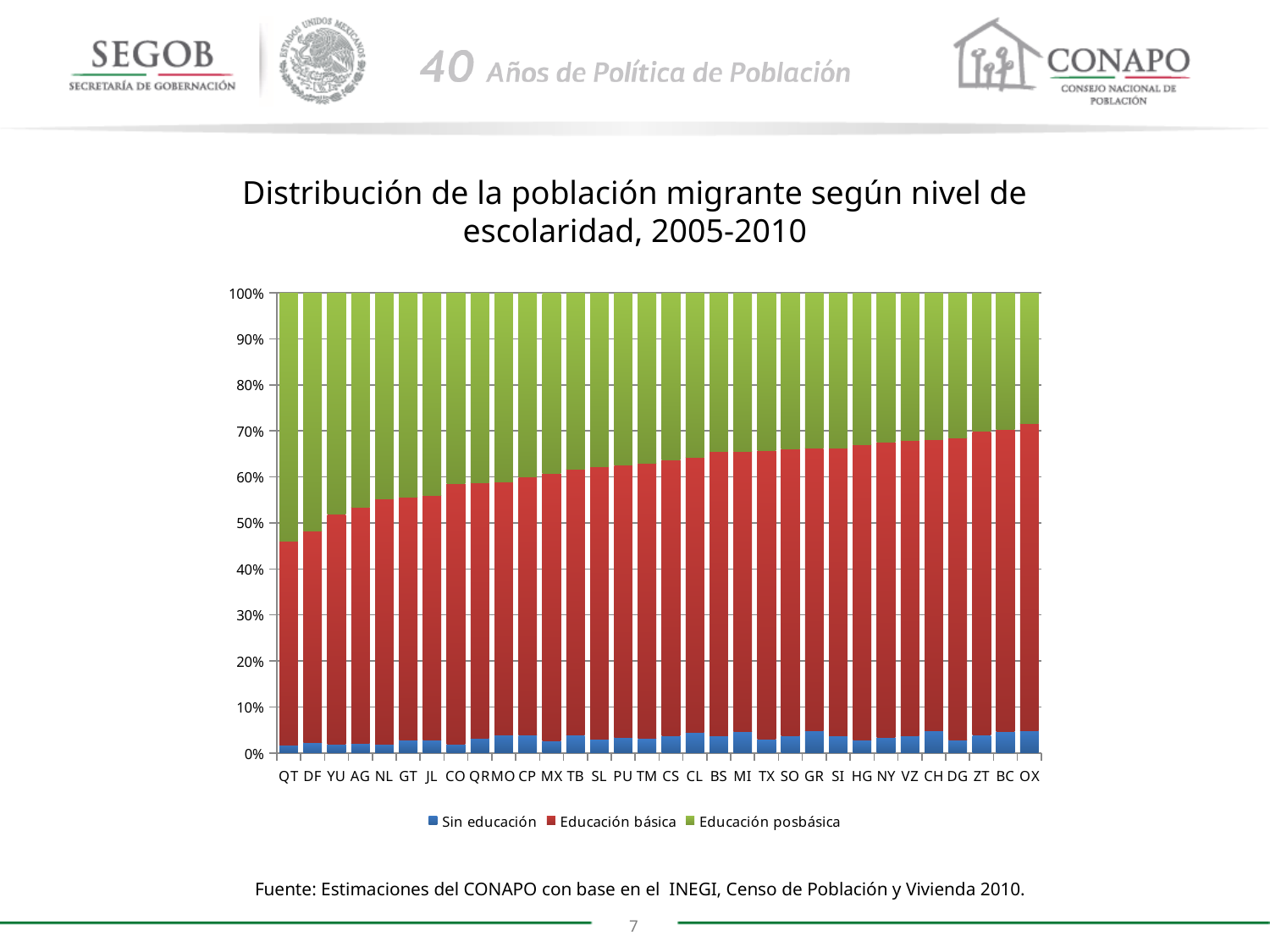
For QT, is the top of the Educación básica segment greater or less than 50%? less What kind of chart is shown on the slide? Stacked bar chart How many series does the legend list? 3 For OX, is the top of the Educación básica segment greater or less than 60%? greater Which category has the smallest Educación posbásica share? OX Which category has the largest Educación posbásica share? QT What is the total of the stacked bar for QT? 100% How many categories (states) are plotted along the x axis? 32 What is the title of the chart? Distribución de la población migrante según nivel de escolaridad, 2005-2010 Does the Educación posbásica share rise or fall moving from left to right along the x axis? fall Which has the larger Educación posbásica share, DF or BC? DF Which colour represents Educación posbásica in the chart? Green